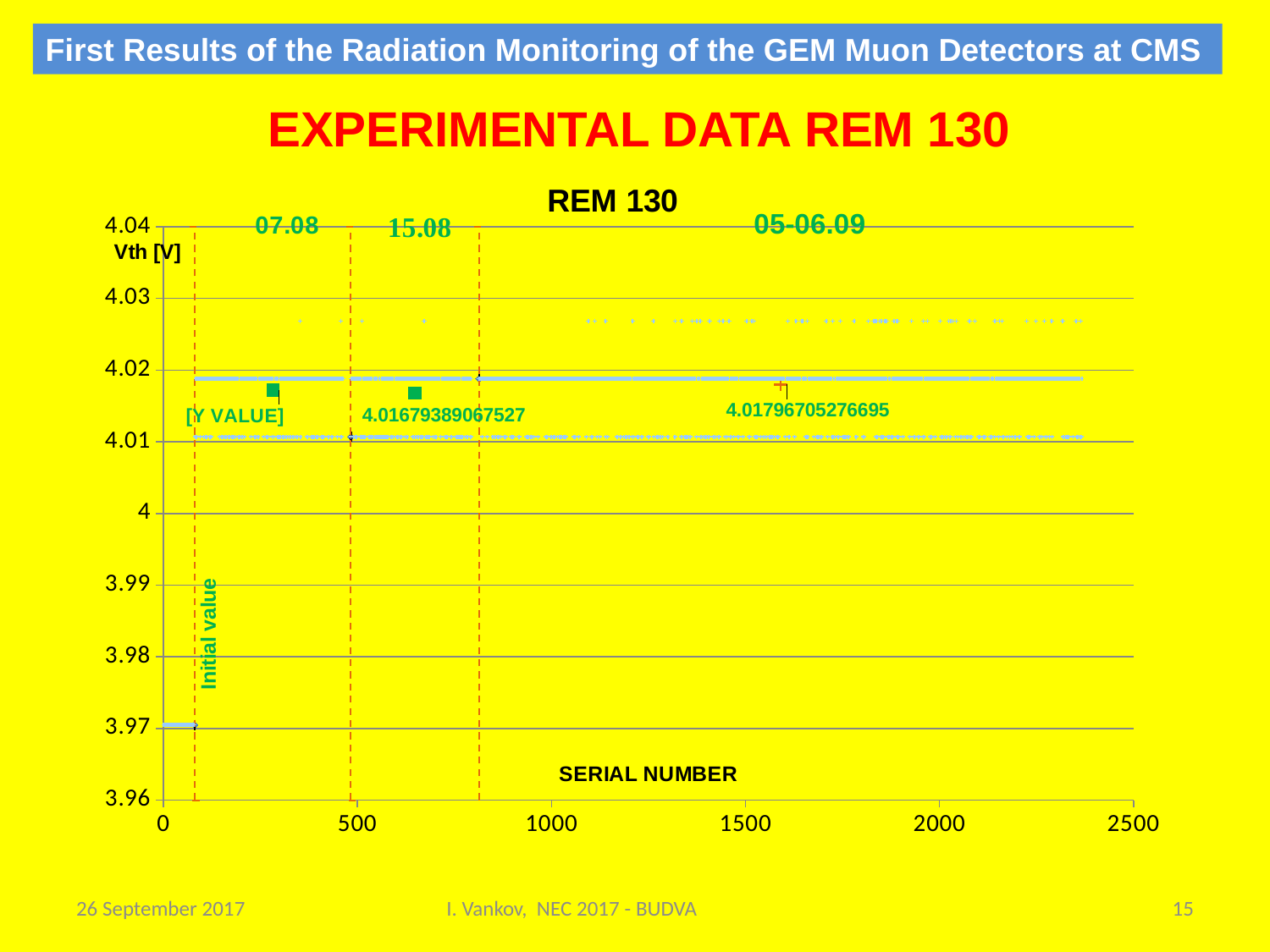
What is the label of the y axis of the chart? Vth [V] Which printed data label is larger: 4.01679389067527 or 4.01796705276695? 4.01796705276695 What is the title of the chart? REM 130 What is the difference between the printed values 4.01796705276695 and 4.01679389067527? 0.00117316209168 What is the value printed on the data label near serial number 650 (the second green marker)? 4.01679389067527 What kind of chart is shown on the slide? scatter chart What is the largest serial number shown on the x axis? 2500 What is the highest value shown on the y axis? 4.04 What is the value printed on the data label near serial number 1600? 4.01796705276695 Is the value of the point marked 'Initial value' greater or less than 3.98 V? less Is the point marked 'Initial value' at serial number near 0 greater or less than 4 V? less